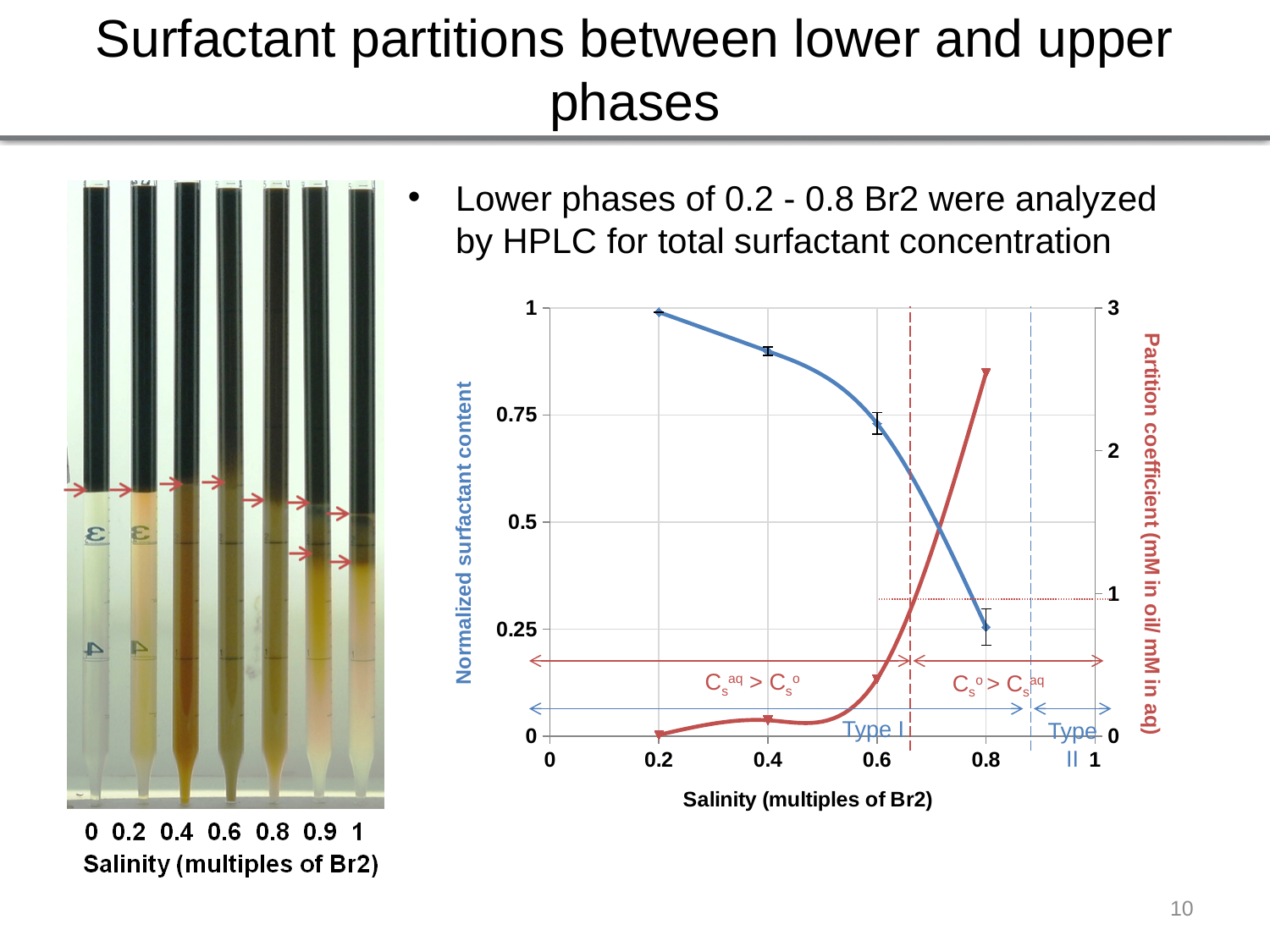
Is the normalized surfactant content at salinity 0.8 greater or less than 0.5? less What kind of chart is shown on the slide? line chart Does the normalized surfactant content rise or fall as salinity increases? fall What is the title of the x axis of the chart? Salinity (multiples of Br2) At which salinity is the normalized surfactant content lowest? 0.8 At which salinity is the partition coefficient highest? 0.8 Is the partition coefficient at salinity 0.6 greater or less than 1? less How many data points are plotted for the normalized surfactant content series? 4 Is the partition coefficient at salinity 0.8 greater or less than 2? greater Does the partition coefficient rise or fall as salinity increases? rise What is the title of the left y axis of the chart? Normalized surfactant content